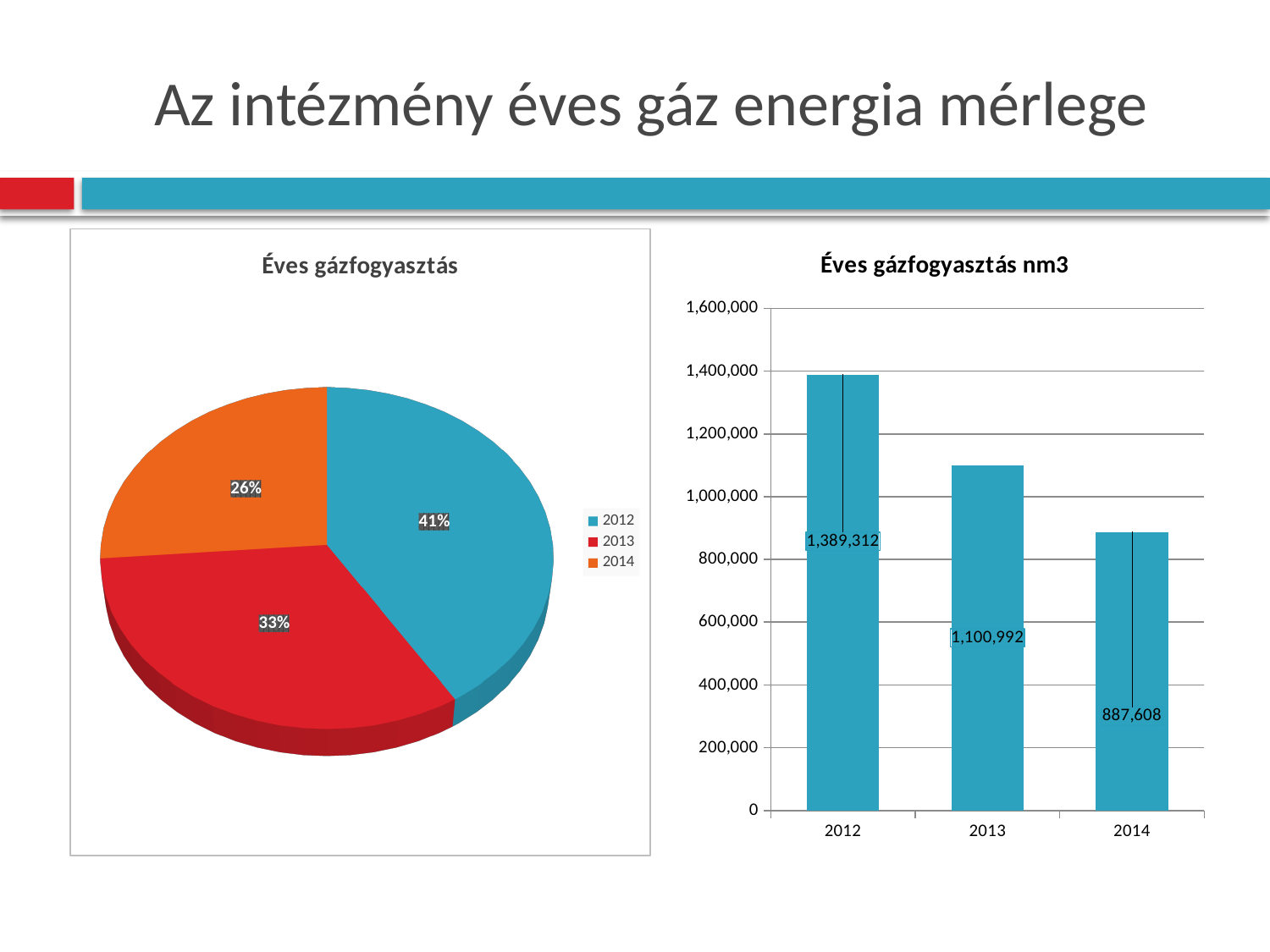
In the 'Éves gázfogyasztás nm3' bar chart, what is the value for 2012? 1,389,312 In the 'Éves gázfogyasztás nm3' bar chart, is the value for 2013 greater or less than 1,000,000? greater In the 'Éves gázfogyasztás nm3' bar chart, which year has the lowest value? 2014 In the 'Éves gázfogyasztás nm3' bar chart, do values rise or fall from 2012 to 2014? fall How many entries does the legend of the 'Éves gázfogyasztás' pie chart list? 3 In the 'Éves gázfogyasztás' pie chart, what share does 2013 have? 33% In the 'Éves gázfogyasztás nm3' bar chart, which year has the highest value? 2012 How many bars are in the 'Éves gázfogyasztás nm3' chart? 3 What kind of chart is the 'Éves gázfogyasztás' chart on the left? pie chart In the 'Éves gázfogyasztás nm3' bar chart, what is the value for 2014? 887,608 In the 'Éves gázfogyasztás' pie chart, which year has the smallest slice? 2014 In the 'Éves gázfogyasztás nm3' bar chart, what is the difference between the 2012 and 2013 values? 288,320